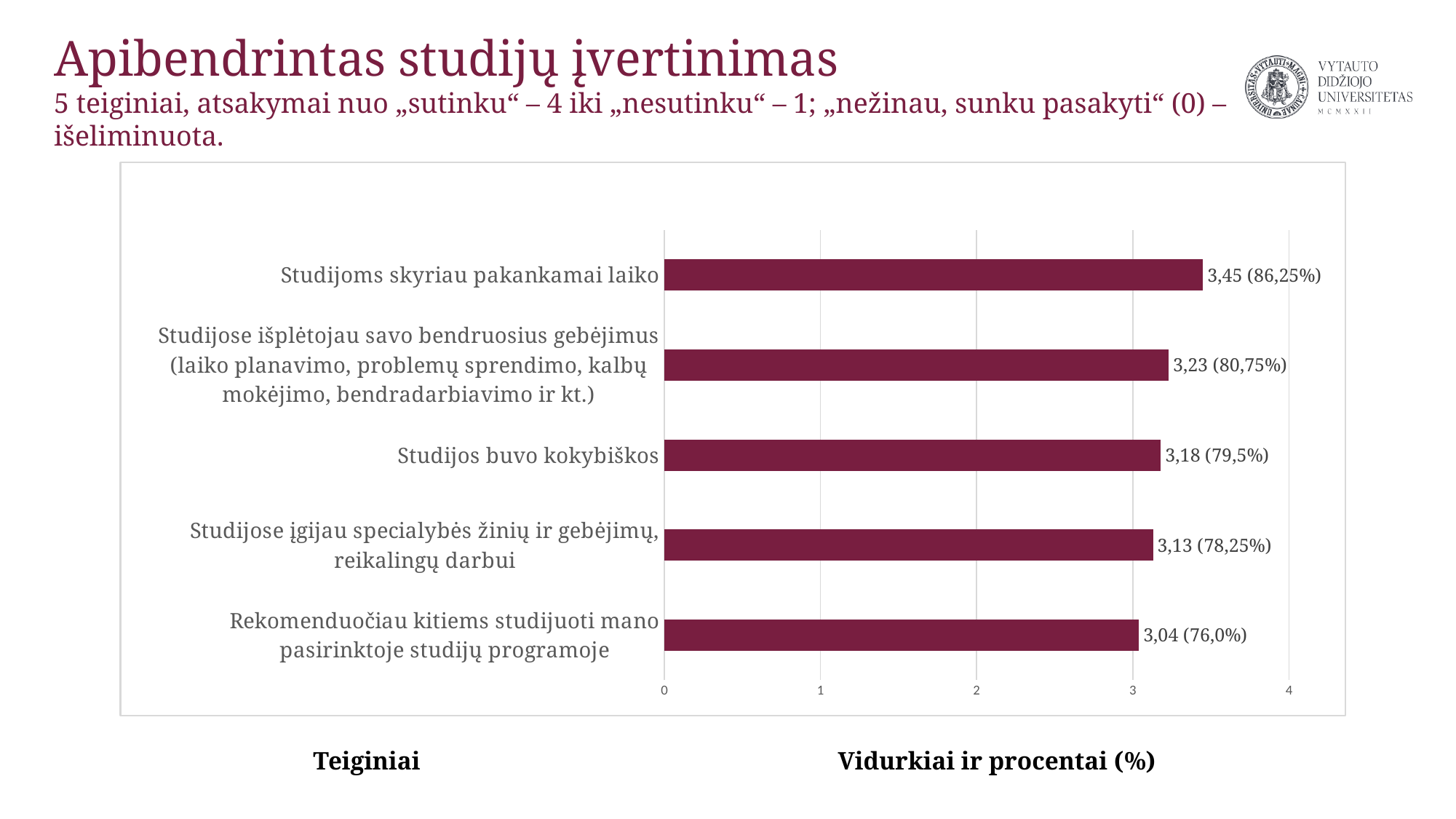
What kind of chart is shown on the slide? bar chart What is the value shown for "Studijoms skyriau pakankamai laiko"? 3,45 (86,25%) Which has a higher average: "Studijos buvo kokybiškos" or "Studijose išplėtojau savo bendruosius gebėjimus (laiko planavimo, problemų sprendimo, kalbų mokėjimo, bendradarbiavimo ir kt.)"? Studijose išplėtojau savo bendruosius gebėjimus (laiko planavimo, problemų sprendimo, kalbų mokėjimo, bendradarbiavimo ir kt.) What is the value shown for "Studijos buvo kokybiškos"? 3,18 (79,5%) What percentage is shown for "Studijose įgijau specialybės žinių ir gebėjimų, reikalingų darbui"? 78,25% What is the value shown for "Rekomenduočiau kitiems studijuoti mano pasirinktoje studijų programoje"? 3,04 (76,0%) Is the value for "Rekomenduočiau kitiems studijuoti mano pasirinktoje studijų programoje" greater or less than 3? greater How many statements (bars) are shown in the chart? 5 What is the label shown under the value axis of the chart? Vidurkiai ir procentai (%) Which statement has the highest average value? Studijoms skyriau pakankamai laiko Which statement has the lowest average value? Rekomenduočiau kitiems studijuoti mano pasirinktoje studijų programoje What is the difference between the average for "Studijoms skyriau pakankamai laiko" and the average for "Rekomenduočiau kitiems studijuoti mano pasirinktoje studijų programoje"? 0,41